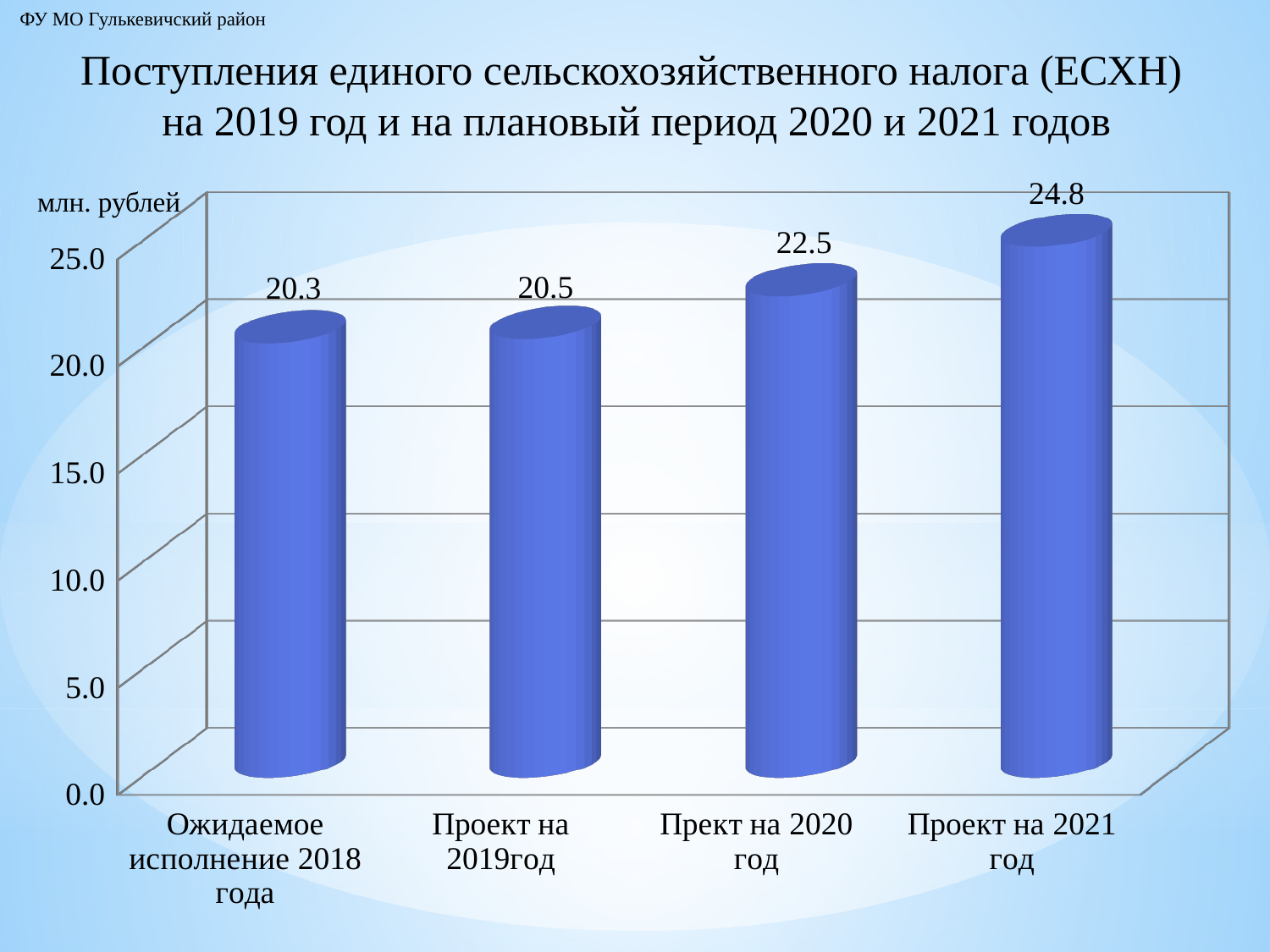
What is the difference between the values for "Проект на 2021 год" and "Прект на 2020 год"? 2.3 Which category has the highest value? Проект на 2021 год What is the value for "Проект на 2019год"? 20.5 What is the value for "Прект на 2020 год"? 22.5 How many categories are shown on the chart? 4 What is the value for "Проект на 2021 год"? 24.8 Which is larger: the value for "Прект на 2020 год" or the value for "Проект на 2019год"? Прект на 2020 год Which category has the lowest value? Ожидаемое исполнение 2018 года Do the values rise or fall from left to right along the x axis? Rise What is the difference between the values for "Проект на 2021 год" and "Ожидаемое исполнение 2018 года"? 4.5 What kind of chart is shown on the slide? Bar chart What is the value for "Ожидаемое исполнение 2018 года"? 20.3